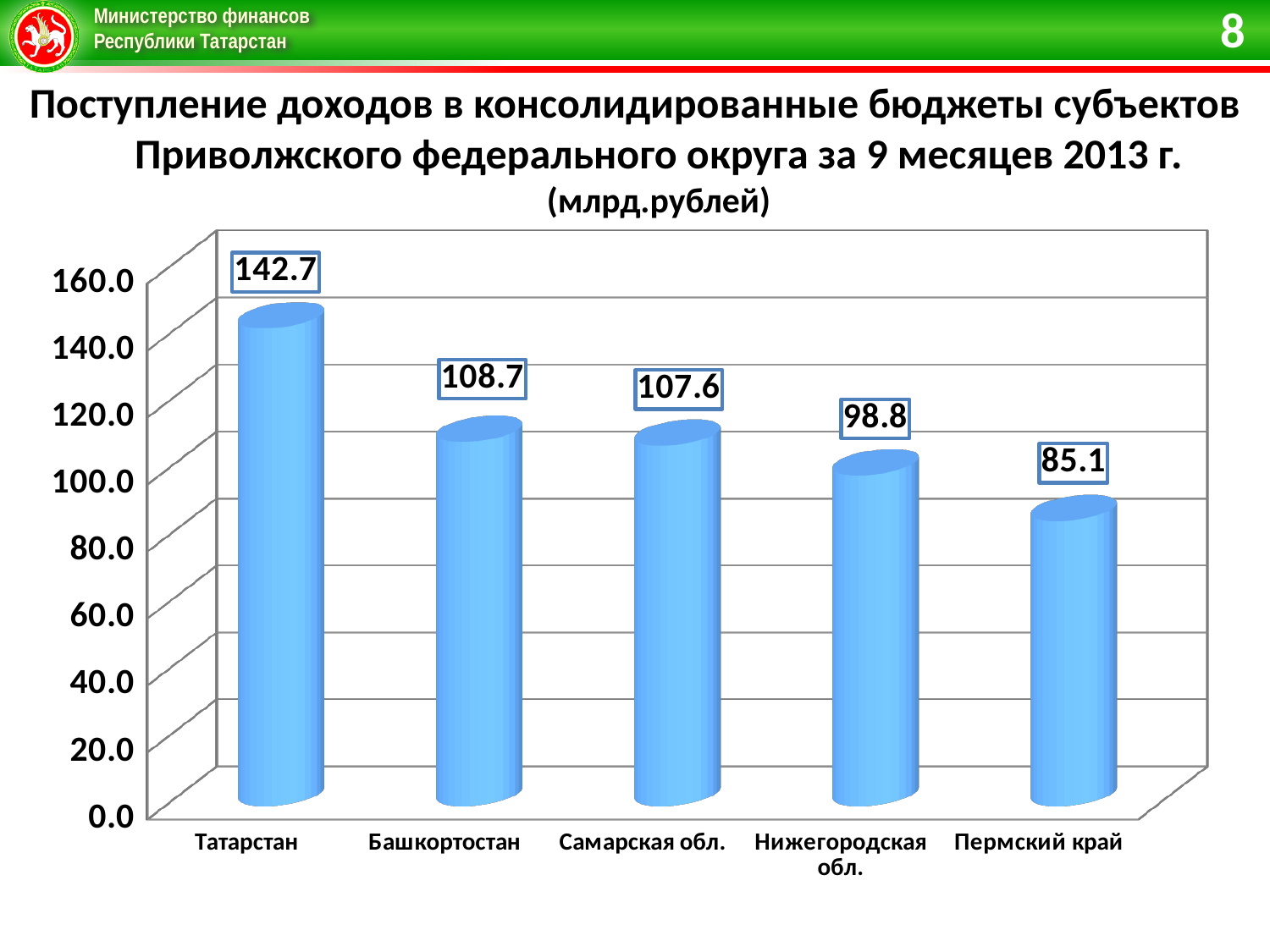
Which region has the lowest value? Пермский край In what units are the values on the chart expressed? млрд.рублей What is the value for Нижегородская обл.? 98.8 What is the value for Пермский край? 85.1 How many regions are shown on the chart? 5 What is the value for Татарстан? 142.7 What kind of chart is shown on the slide? bar chart Is the value for Нижегородская обл. greater or less than 100.0? less What is the difference between the values for Татарстан and Башкортостан? 34.0 What is the difference between the values for Нижегородская обл. and Пермский край? 13.7 Which is larger, the value for Башкортостан or the value for Самарская обл.? Башкортостан Which region has the highest value? Татарстан